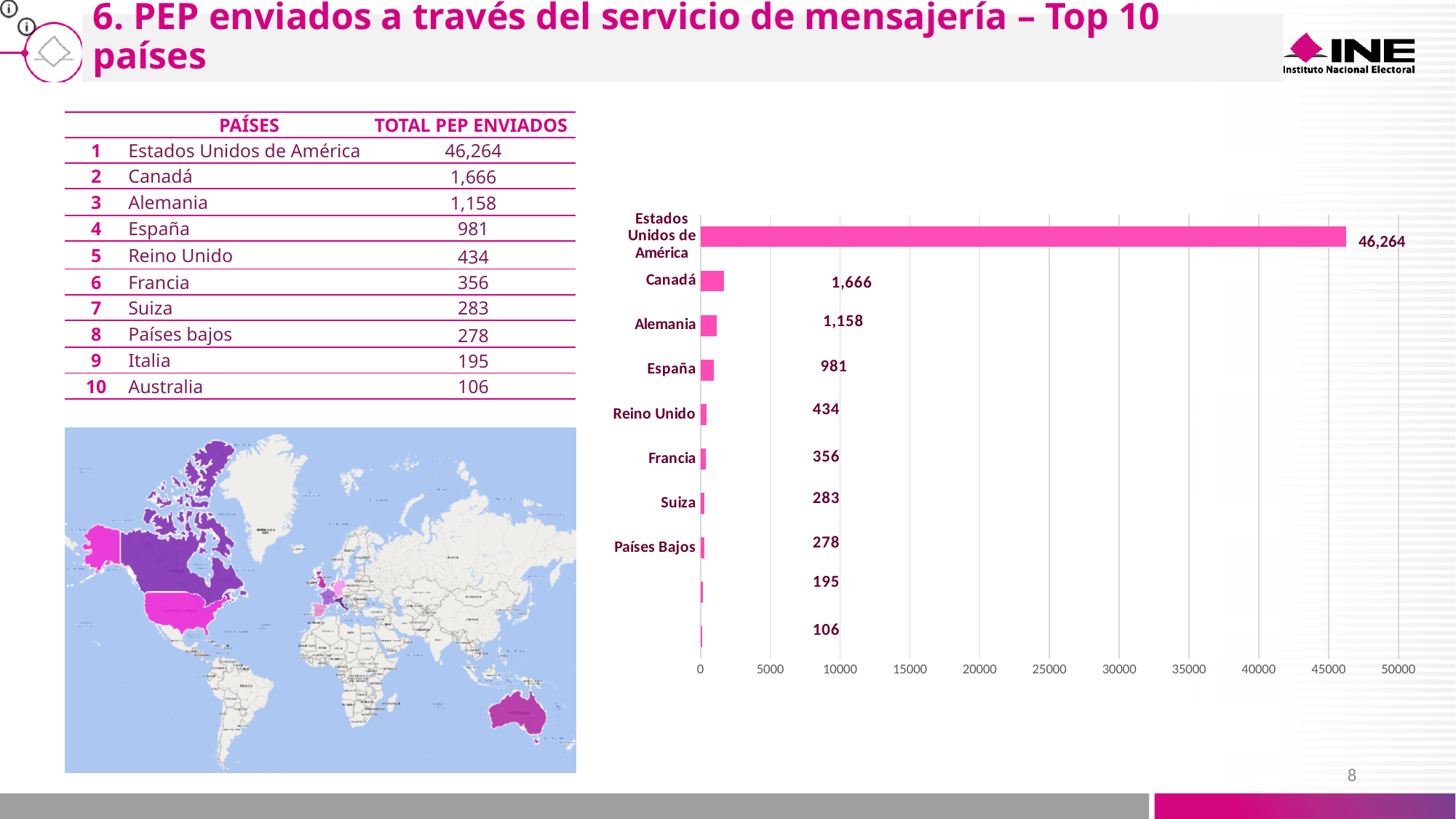
What is the difference between the values for España and Reino Unido in the bar chart? 547 Is the value for Estados Unidos de América in the bar chart greater or less than 45000? greater How many bars are plotted in the bar chart? 10 What kind of chart is shown on the right of the slide? Bar chart What is the value for Suiza in the bar chart? 283 What is the highest value shown on the horizontal axis of the bar chart? 50000 Which country has the highest value in the bar chart? Estados Unidos de América What is the value for Reino Unido in the bar chart? 434 What is the value for Alemania in the bar chart? 1,158 What is the value for Canadá in the bar chart? 1,666 What is the difference between the values for Canadá and Alemania in the bar chart? 508 Which is larger in the bar chart, the value for Francia or the value for Países Bajos? Francia